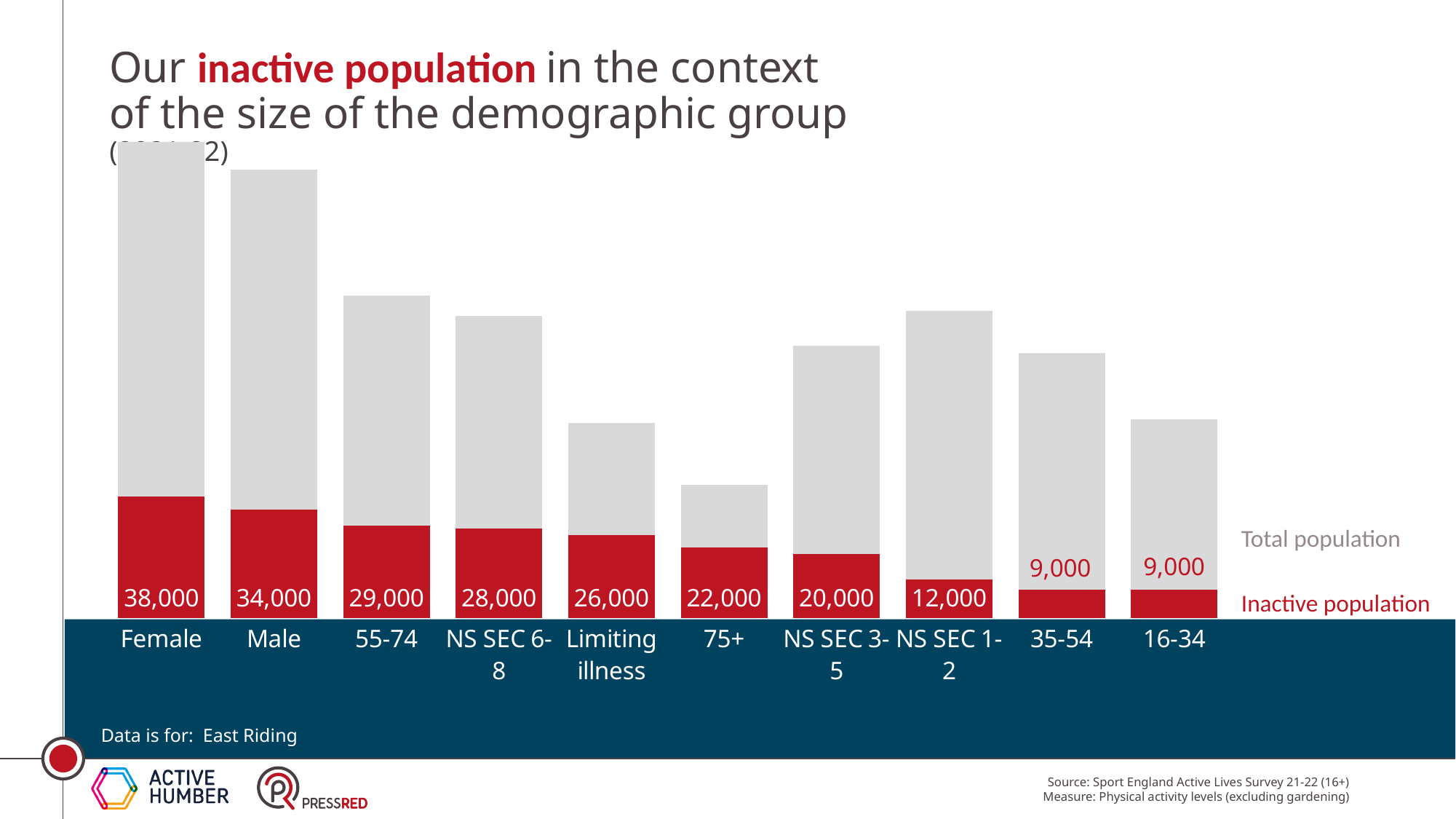
What is the inactive population for the 75+ age group? 22,000 Which demographic group has the highest inactive population? Female Which has a larger inactive population, the 55-74 group or the 75+ group? 55-74 What kind of chart is shown on the slide? Bar chart What is the difference between the inactive population of the 55-74 group and the 16-34 group? 20,000 How many demographic groups are shown on the chart? 10 What is the inactive population for the Female group? 38,000 What is the inactive population for the NS SEC 1-2 group? 12,000 How many series does the chart's legend list? 2 Do the inactive population values rise or fall from left to right across the chart? Fall What is the difference between the inactive population of the Female group and the Male group? 4,000 What is the inactive population for the Limiting illness group? 26,000